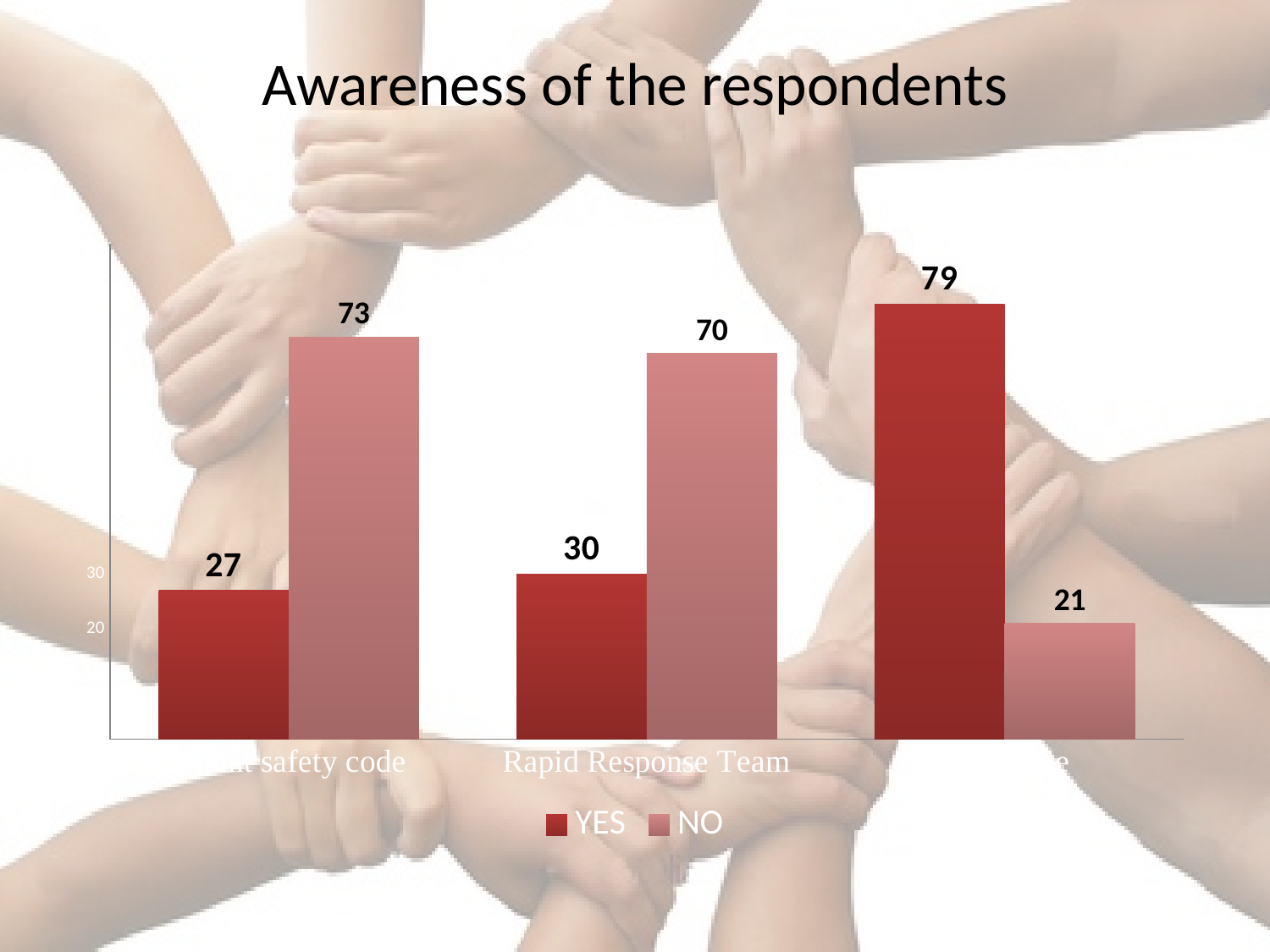
What are the two series named in the legend? YES and NO For Rapid Response Team, how much larger is the NO value than the YES value? 40 What is the title of the chart? Awareness of the respondents What is the lowest YES value shown on the chart? 27 What is the lowest value shown on the chart? 21 What is the YES value for Rapid Response Team? 30 What is the highest value shown on the chart? 79 How many categories are shown on the x axis? 3 What is the NO value for Rapid Response Team? 70 For Rapid Response Team, which is larger, YES or NO? NO How many series does the legend list? 2 What kind of chart is shown on the slide? Bar chart